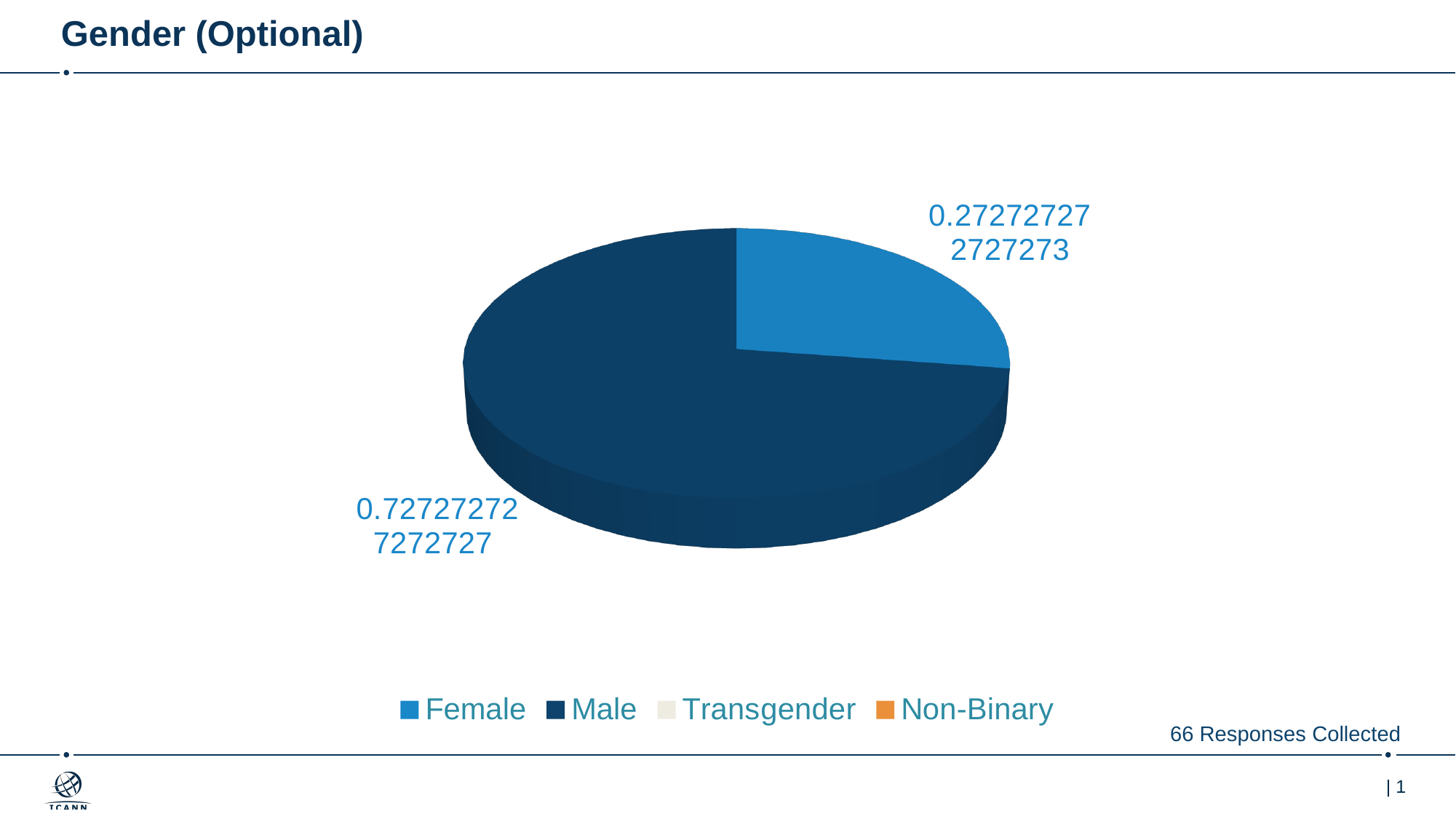
How many categories does the legend list? 4 What is the value shown for the Female slice? 0.272727272727273 Which is larger, the Female slice or the Male slice? Male How many responses were collected according to the slide? 66 What is the value shown for the Male slice? 0.727272727272727 What is the title of the slide? Gender (Optional) Is the value for Female greater or less than 0.5? less Which category has the largest slice of the pie? Male What share of the pie does the Male slice represent? 0.727272727272727 Is the value for Male greater or less than 0.5? greater What kind of chart is shown on the slide? Pie chart